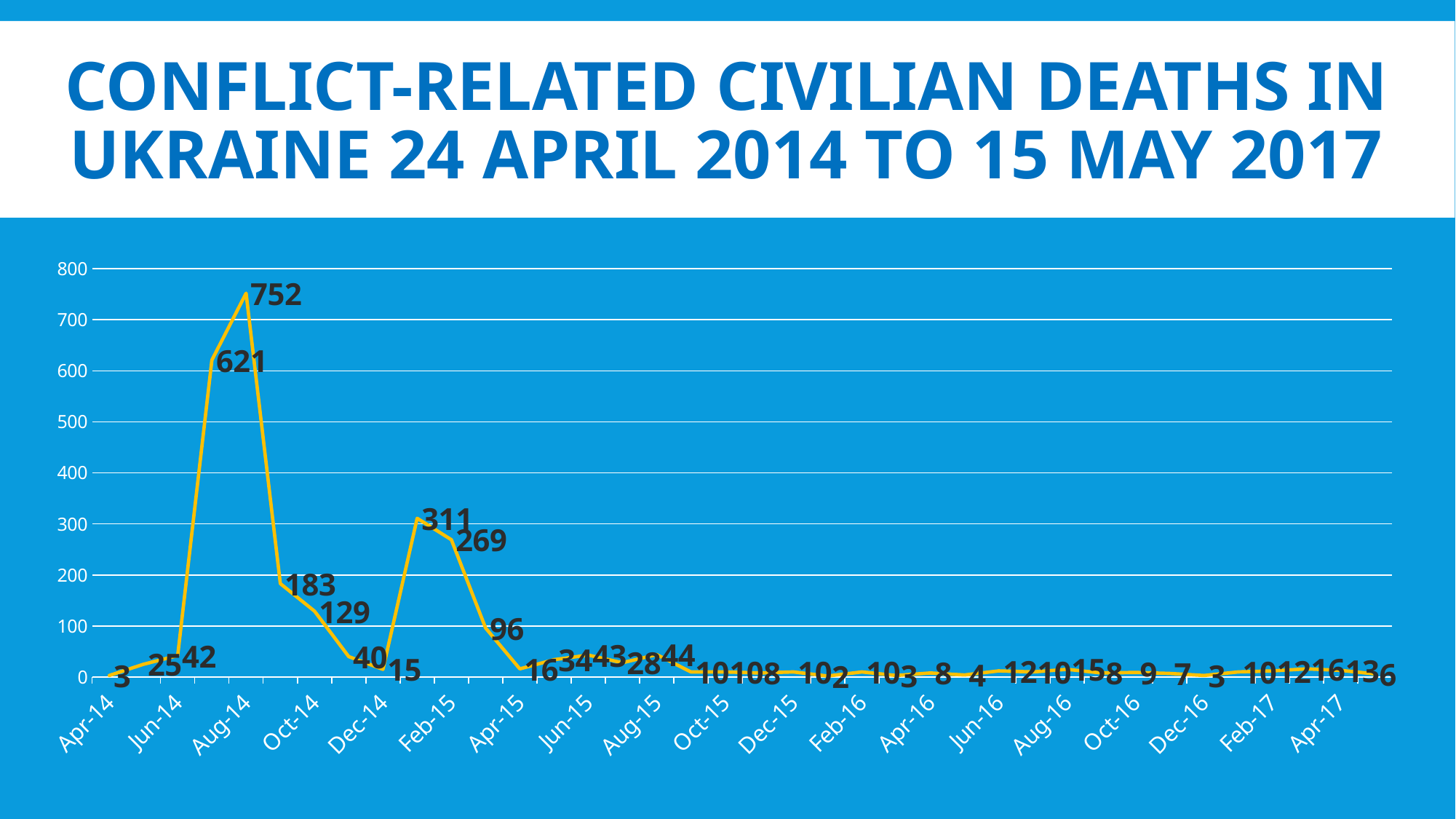
What kind of chart is shown on the slide? line chart Do the values rise or fall from Aug-14 to Dec-14? fall What is the value for Dec-14? 15 Which is larger, the value for Oct-14 or the value for Feb-15? Feb-15 What is the value for Oct-14? 129 Is the value for Jun-14 greater or less than 100? less What is the difference between the value for Aug-14 and the value for Feb-15? 483 In which month does the chart reach its highest value? Aug-14 What is the value for Feb-15? 269 What is the title of the chart? CONFLICT-RELATED CIVILIAN DEATHS IN UKRAINE 24 APRIL 2014 TO 15 MAY 2017 What is the highest value plotted on the chart? 752 What is the value for Apr-14? 3